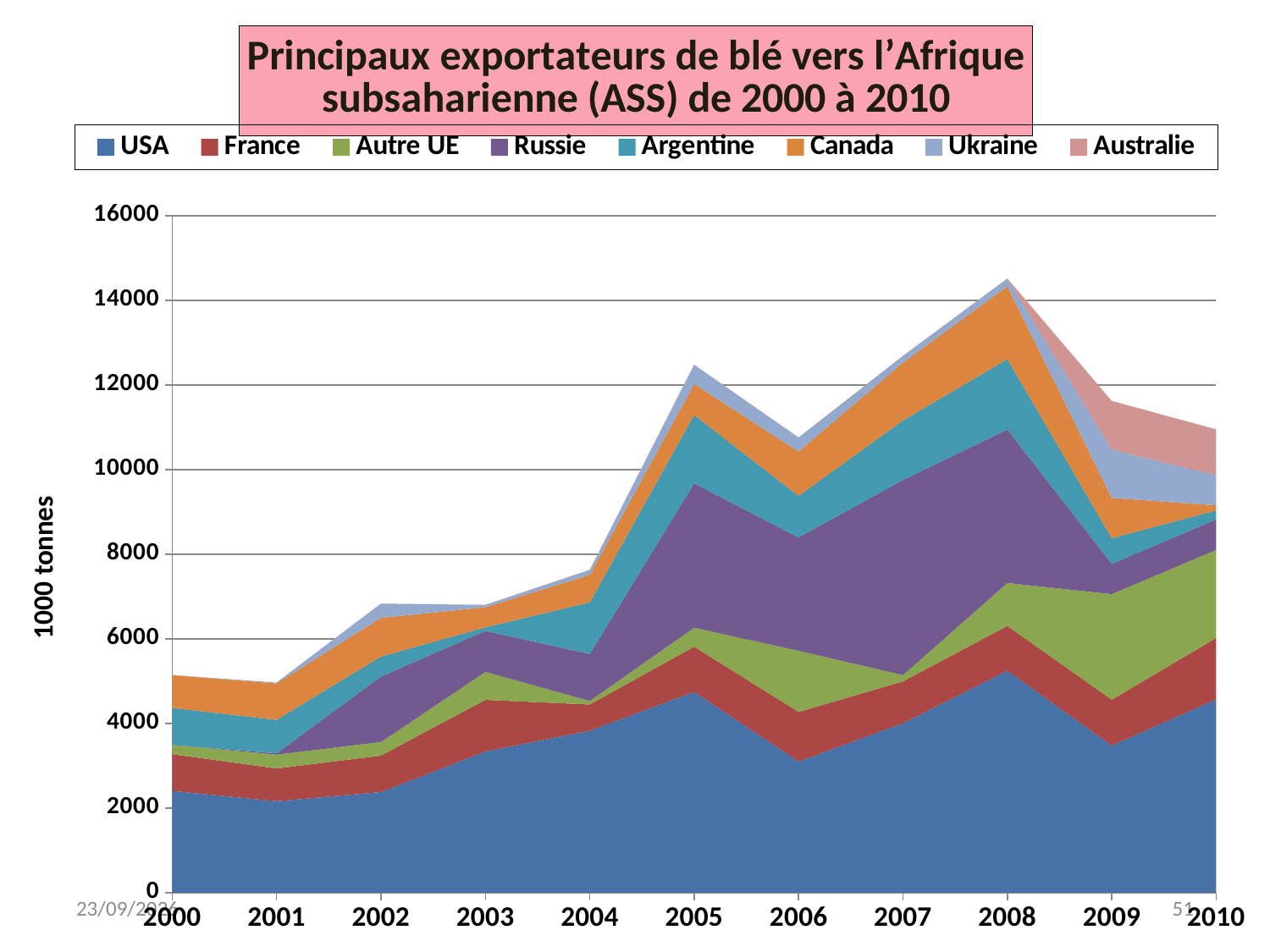
What is the title of the chart? Principaux exportateurs de blé vers l'Afrique subsaharienne (ASS) de 2000 à 2010 Which year has a larger total, 2005 or 2006? 2005 Is the value for USA in 2000 greater or less than 2000? greater What is the label of the y axis? 1000 tonnes In which year is the total of all exporters highest? 2008 What kind of chart is shown on the slide? Stacked area chart Is the total value for 2000 greater or less than 6000? less Is the total value for 2008 greater or less than 14000? greater How many years are plotted along the x axis? 11 Does the total of all exporters rise or fall from 2000 to 2008? rise How many series does the legend list? 8